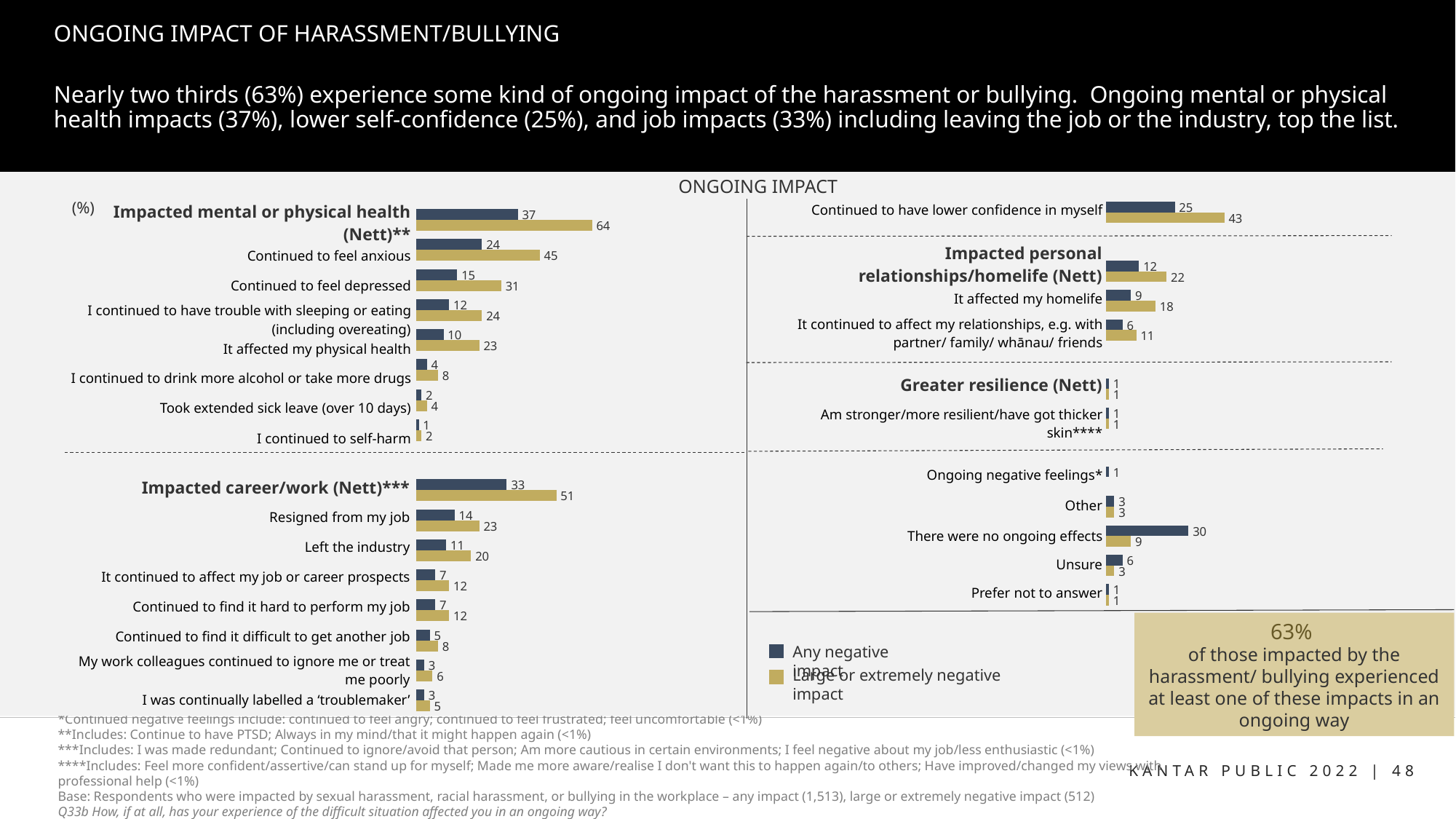
Which is larger: the 'Any negative impact' value for 'Continued to feel depressed' or for 'Resigned from my job'? Continued to feel depressed What is the difference between the 'Any negative impact' and 'Large or extremely negative impact' values for 'There were no ongoing effects'? 21 How many series does the chart legend list? 2 What is the value for 'Any negative impact' for 'Impacted mental or physical health (Nett)**'? 37 What is the value for 'Large or extremely negative impact' for 'Continued to have lower confidence in myself'? 43 What kind of chart is shown on the slide? Bar chart Which category has the highest value for 'Large or extremely negative impact'? Impacted mental or physical health (Nett)** What is the value for 'Any negative impact' for 'There were no ongoing effects'? 30 What is the value for 'Large or extremely negative impact' for 'Continued to feel anxious'? 45 Which is larger for 'Resigned from my job': the 'Any negative impact' value or the 'Large or extremely negative impact' value? Large or extremely negative impact What is the value for 'Any negative impact' for 'Left the industry'? 11 What is the difference between the 'Large or extremely negative impact' and 'Any negative impact' values for 'Impacted career/work (Nett)***'? 18